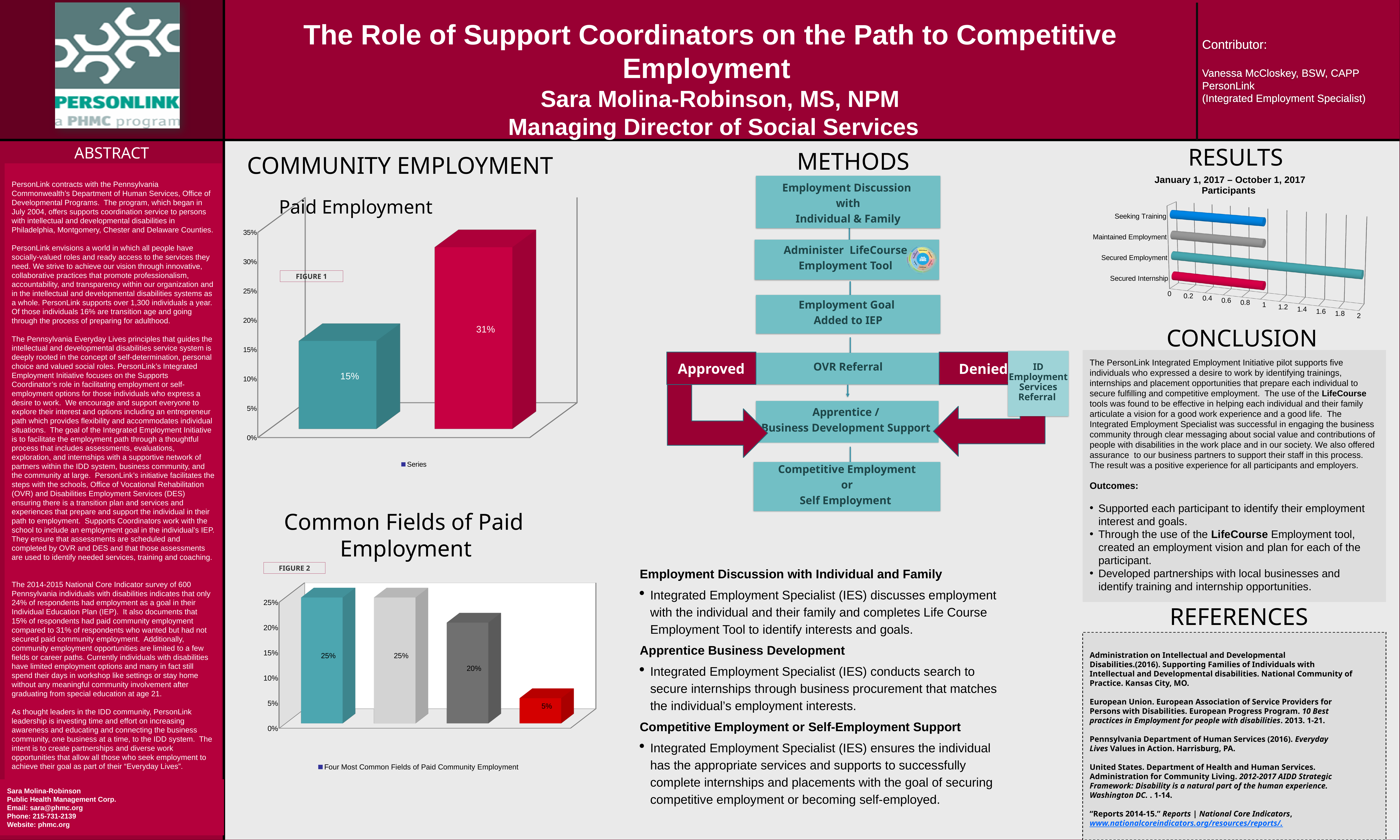
How many bars are plotted in the Paid Employment chart? 2 How many bars are plotted in the Common Fields of Paid Employment chart? 4 In the January 1, 2017 – October 1, 2017 Participants chart, which category has the highest value? Secured Employment In the Paid Employment chart, what is the value of the tallest bar? 31% What kind of chart is the Paid Employment chart? bar chart What legend entry is shown under the Paid Employment chart? Series In the Paid Employment chart, what is the difference between the two bars' values? 16 percentage points In the Common Fields of Paid Employment chart, what is the difference between the highest bar value and the lowest bar value? 20 percentage points What legend entry is shown under the Common Fields of Paid Employment chart? Four Most Common Fields of Paid Community Employment In the January 1, 2017 – October 1, 2017 Participants chart, is the value for Secured Internship greater or less than 1.6? less In the Common Fields of Paid Employment chart, what is the value of the lowest bar? 5% In the Paid Employment chart, what is the value of the shortest bar? 15%